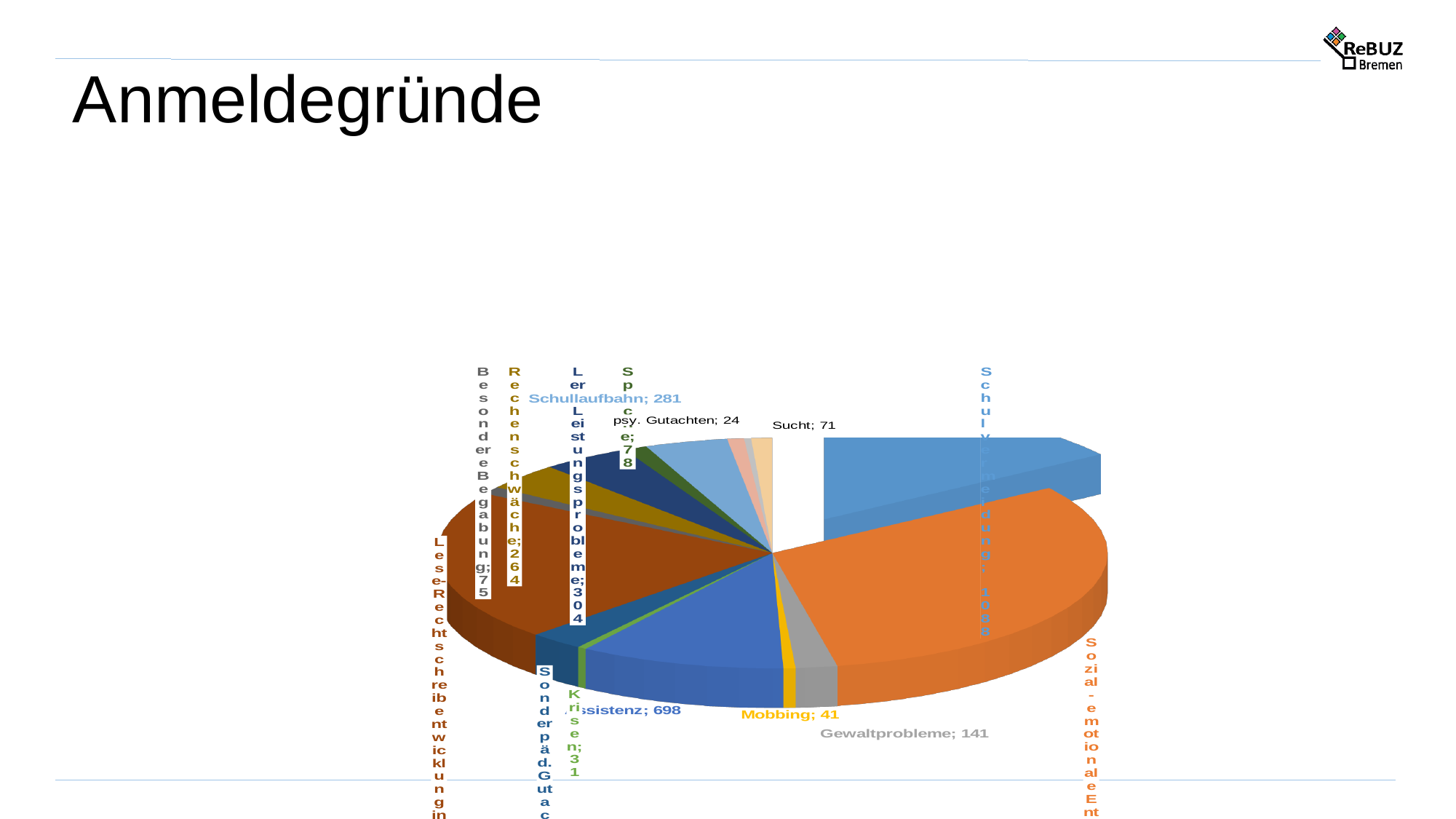
What is the value for Schullaufbahn? 281 What kind of chart is shown on the slide? pie chart What is the value for Sucht? 71 What is the value for psy. Gutachten? 24 What is the value for Mobbing? 41 What is the value for Rechenschwäche? 264 What is the value for Lernleistungsprobleme? 304 Which is larger, Gewaltprobleme or Mobbing? Gewaltprobleme What is the difference between the values for Lernleistungsprobleme and Rechenschwäche? 40 What is the difference between the values for Gewaltprobleme and Mobbing? 100 What is the value for Gewaltprobleme? 141 What is the title of the slide containing the chart? Anmeldegründe